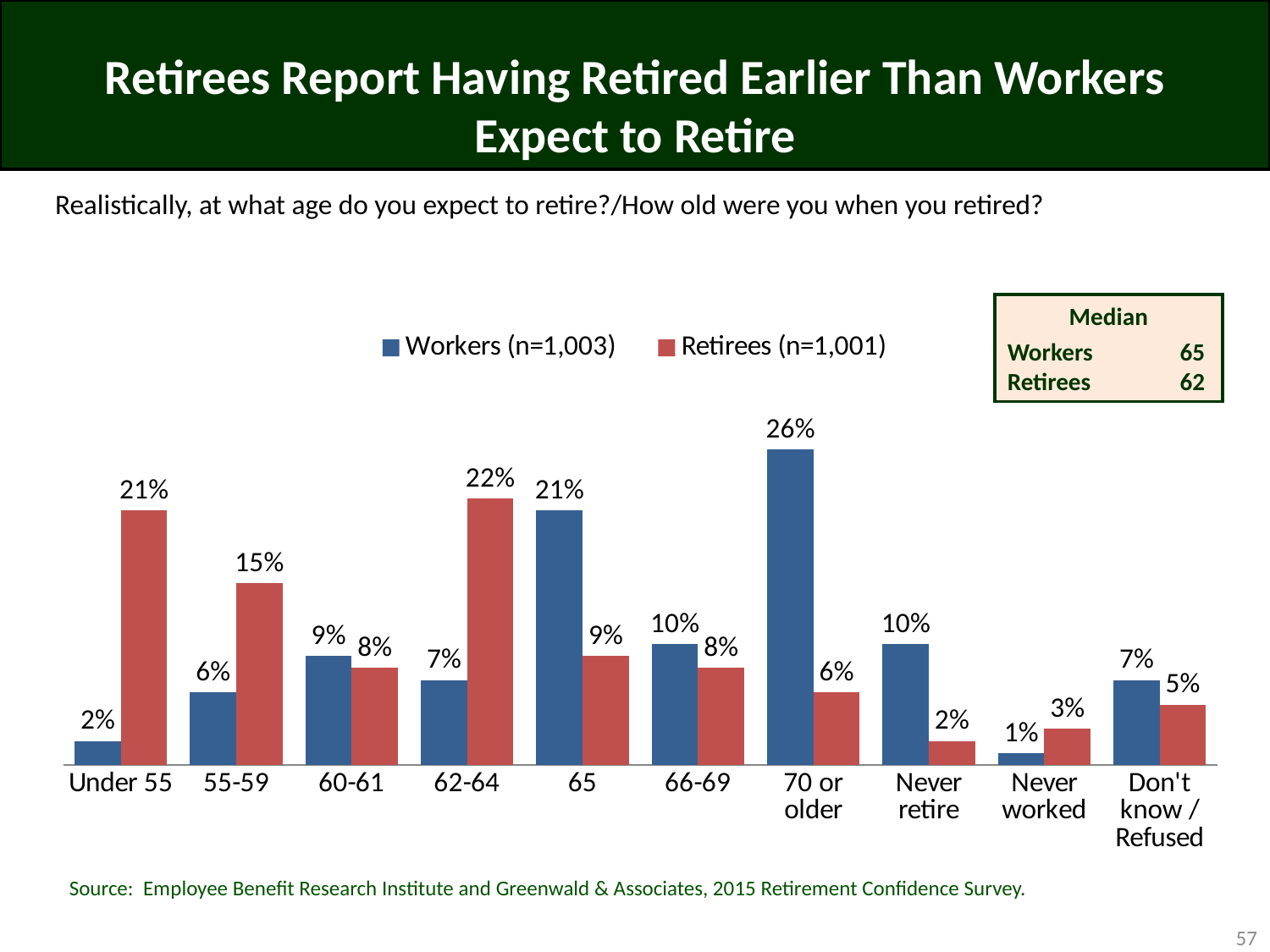
Which category has the highest value for Workers? 70 or older What kind of chart is shown on the slide? Bar chart For the 55-59 category, which is larger, Workers or Retirees? Retirees What percentage of Retirees retired Under 55? 21% What percentage of Workers expect to retire at 70 or older? 26% Which category has the lowest value for Workers? Never worked How many series does the legend list? 2 What is the median expected retirement age for Workers shown in the box? 65 What percentage of Retirees retired at 62-64? 22% How many categories are shown on the x axis? 10 What is the difference between the Workers and Retirees values for 70 or older? 20 percentage points Which category has the highest value for Retirees? 62-64